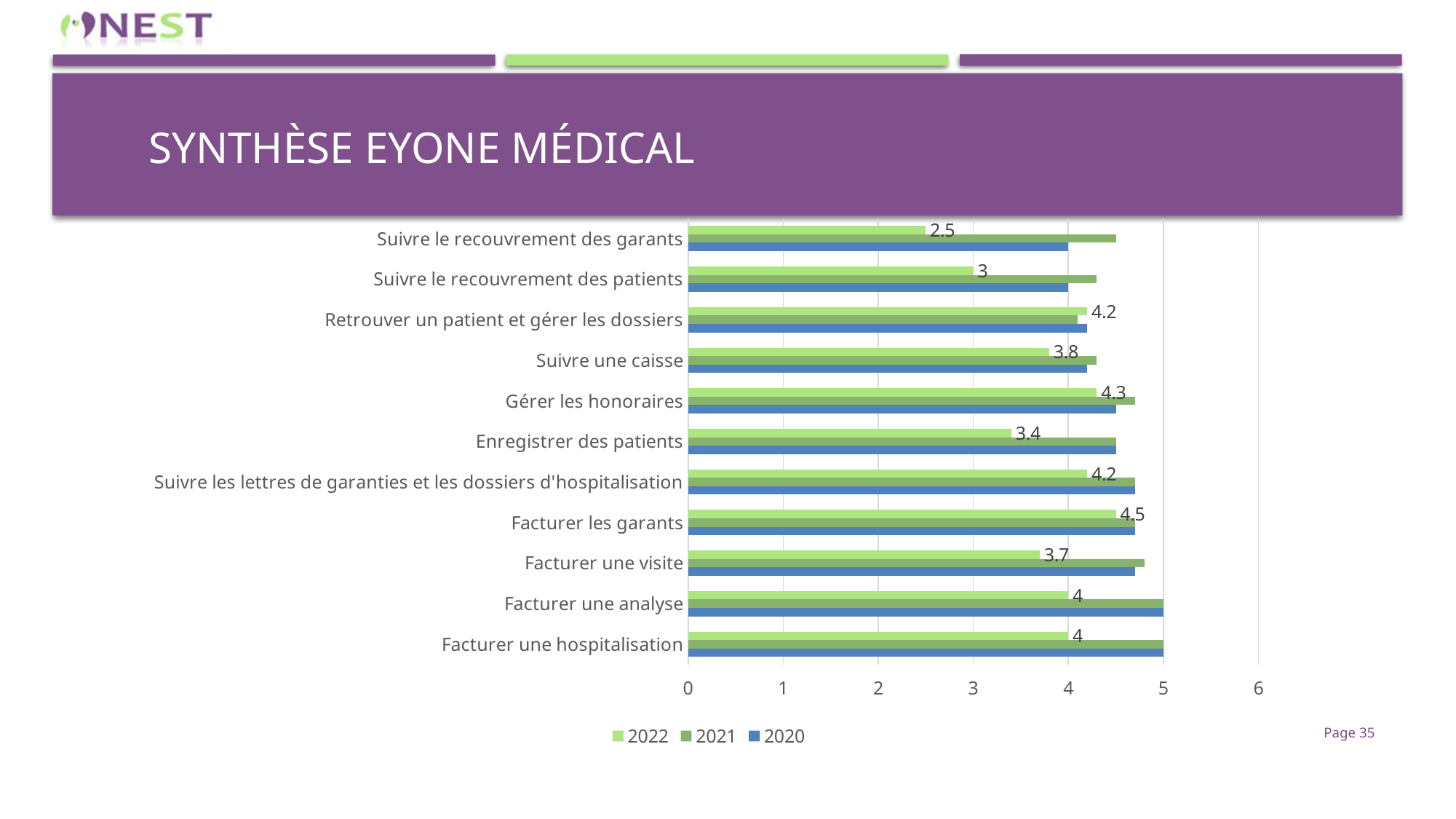
What is the 2022 value for Enregistrer des patients? 3.4 What is the 2022 value for Suivre le recouvrement des garants? 2.5 Which category has the lowest 2022 value? Suivre le recouvrement des garants What is the 2022 value for Facturer les garants? 4.5 What kind of chart is shown on the slide? Bar chart Which has the larger 2022 value, Gérer les honoraires or Suivre une caisse? Gérer les honoraires How many categories are shown on the chart? 11 Which category has the highest 2022 value? Facturer les garants Is the 2021 value for Suivre le recouvrement des garants greater or less than 4? greater What is the difference between the 2022 values for Facturer les garants and Suivre le recouvrement des garants? 2 What is the 2022 value for Facturer une visite? 3.7 How many series does the legend list? 3